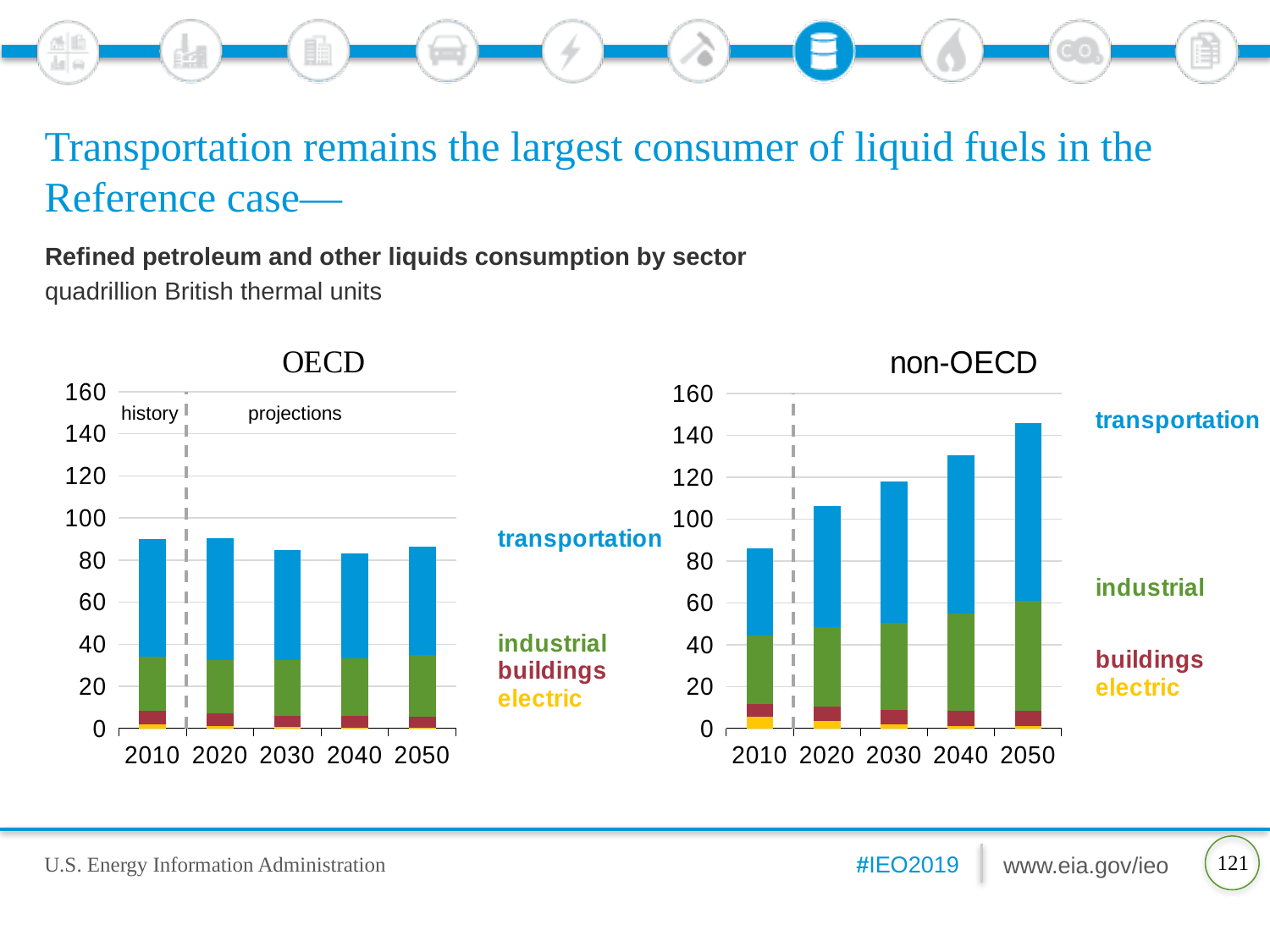
How many sectors are listed in the legend of the non-OECD chart? 4 Do the total bars in the non-OECD chart rise or fall from 2010 to 2050? rise In the non-OECD chart, which year has the highest total consumption? 2050 What kind of chart is the OECD chart? stacked bar chart In the OECD chart, is the total for 2010 greater or less than 100? less In the OECD chart, which sector forms the top (blue) segment of each bar? transportation In the non-OECD chart, is the total for 2050 greater or less than 140? greater Which is larger in 2050: the total for OECD or the total for non-OECD? non-OECD In the non-OECD chart, is the total for 2010 greater or less than 100? less In the non-OECD chart, which year has the lowest total consumption? 2010 How many years are shown on the x axis of the non-OECD chart? 5